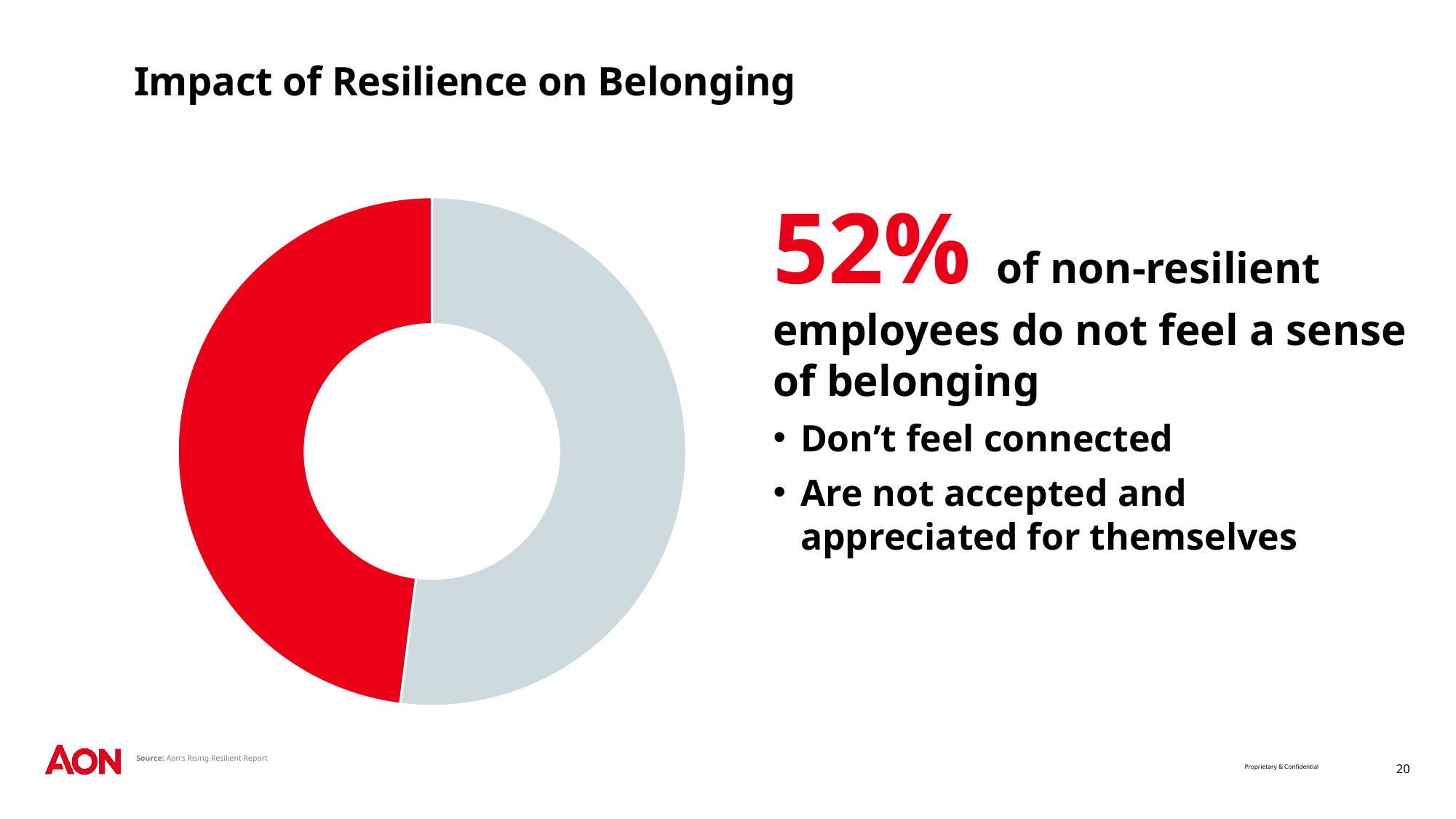
What is the source cited for the chart data? Aon's Rising Resilient Report What percentage of non-resilient employees do not feel a sense of belonging, according to the slide? 52% What colour is the slice representing non-resilient employees who do not feel a sense of belonging? Red How many slices does the donut chart have? 2 What share of the donut chart does the red slice represent? 52% Which slice of the donut chart is larger, the red one or the grey one? The red one What kind of chart is shown on the slide? Donut (pie) chart What is the title of the slide containing the chart? Impact of Resilience on Belonging Is the share of the red slice greater or less than 50%? greater